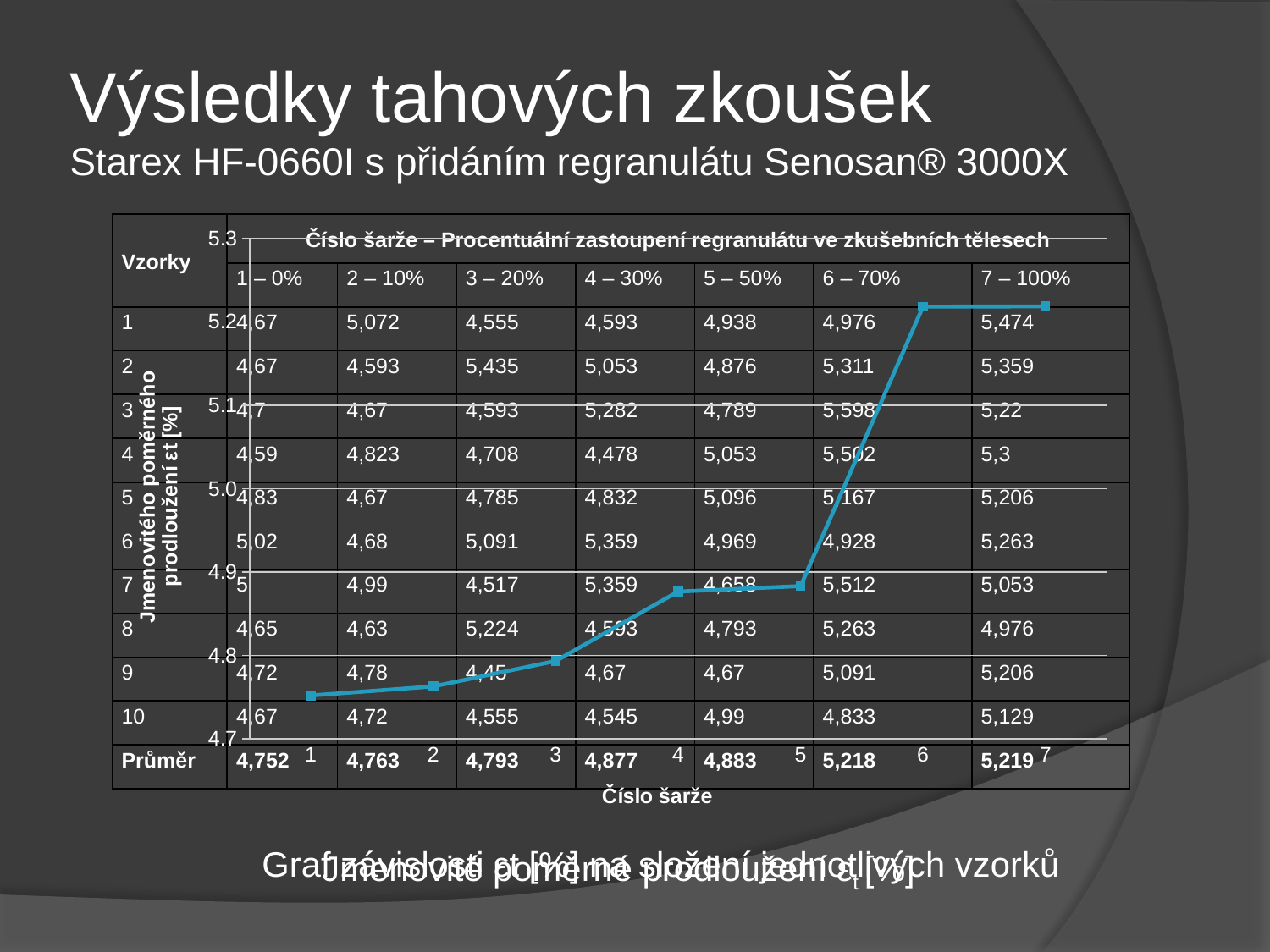
What is the lowest tick value shown on the y axis of the chart? 4.7 What kind of chart is shown on the slide? line chart Is the value for batch 1 greater or less than 4.8? less What is the title of the x axis of the chart? Číslo šarže Is the value for batch 2 greater or less than 4.9? less Is the value for batch 6 greater or less than 5.0? greater Which has the larger plotted value, batch 1 or batch 7? batch 7 Which has the larger plotted value, batch 3 or batch 6? batch 6 How many data points are plotted on the line chart? 7 Do the plotted values generally rise or fall as the batch number (Číslo šarže) increases from 1 to 7? rise